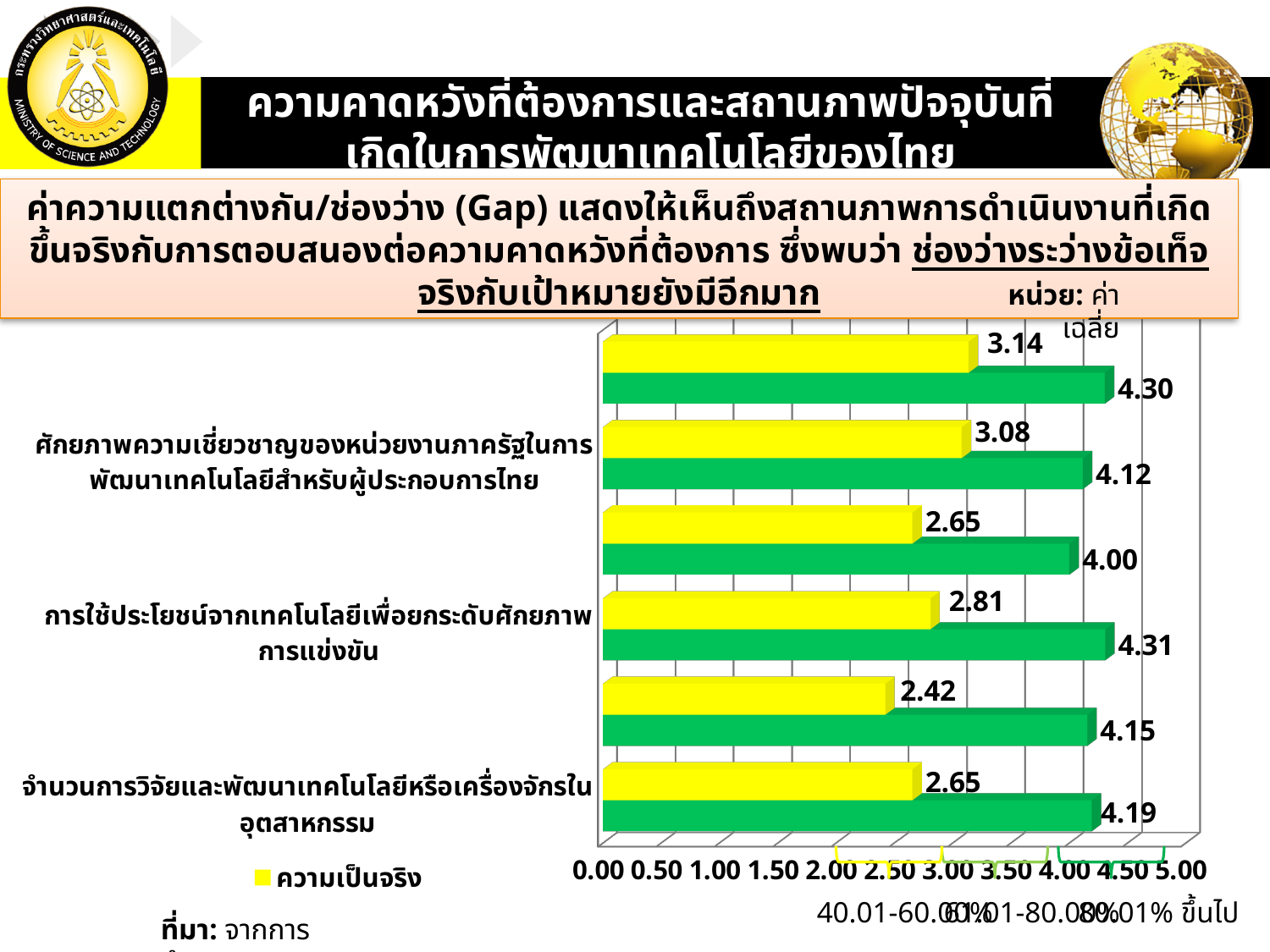
What is the lowest value shown among the yellow bars? 2.42 What is the value of the green bar for การใช้ประโยชน์จากเทคโนโลยีเพื่อยกระดับศักยภาพการแข่งขัน? 4.31 What is the legend label shown for the yellow bars? ความเป็นจริง How many yellow bars are plotted in the chart? 6 Is the value of the yellow bar for การใช้ประโยชน์จากเทคโนโลยีเพื่อยกระดับศักยภาพการแข่งขัน greater or less than 3.00? less What kind of chart is shown on the slide? bar chart What is the lowest value shown among the green bars? 4.00 What is the difference between the green bar and the yellow bar for จำนวนการวิจัยและพัฒนาเทคโนโลยีหรือเครื่องจักรในอุตสาหกรรม? 1.54 What is the highest value shown among the yellow bars? 3.14 Which is larger for ศักยภาพความเชี่ยวชาญของหน่วยงานภาครัฐในการพัฒนาเทคโนโลยีสำหรับผู้ประกอบการไทย, the yellow bar or the green bar? the green bar What is the highest value shown among the green bars? 4.31 What is the value of the yellow bar for ศักยภาพความเชี่ยวชาญของหน่วยงานภาครัฐในการพัฒนาเทคโนโลยีสำหรับผู้ประกอบการไทย? 3.08